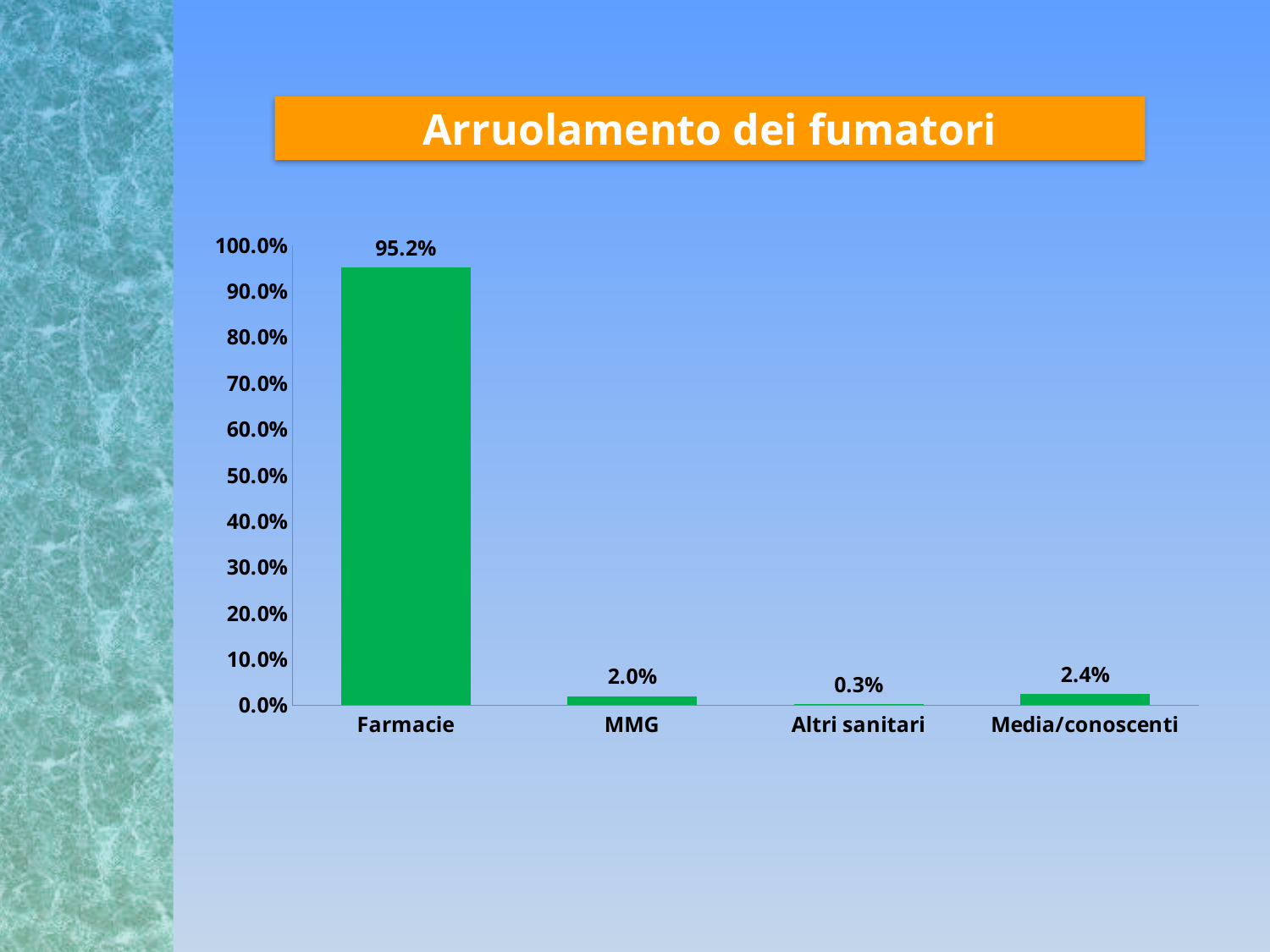
What is the value for MMG? 2.0% What is the value for Media/conoscenti? 2.4% How many categories are shown on the x axis? 4 Is the value for Farmacie greater or less than 90.0%? greater Which category has the highest value? Farmacie What is the difference between the values for Media/conoscenti and MMG? 0.4% What is the value for Farmacie? 95.2% Which is larger, the value for MMG or the value for Altri sanitari? MMG Which category has the lowest value? Altri sanitari What is the value for Altri sanitari? 0.3% What is the difference between the values for Farmacie and Media/conoscenti? 92.8% What kind of chart is shown on the slide? bar chart